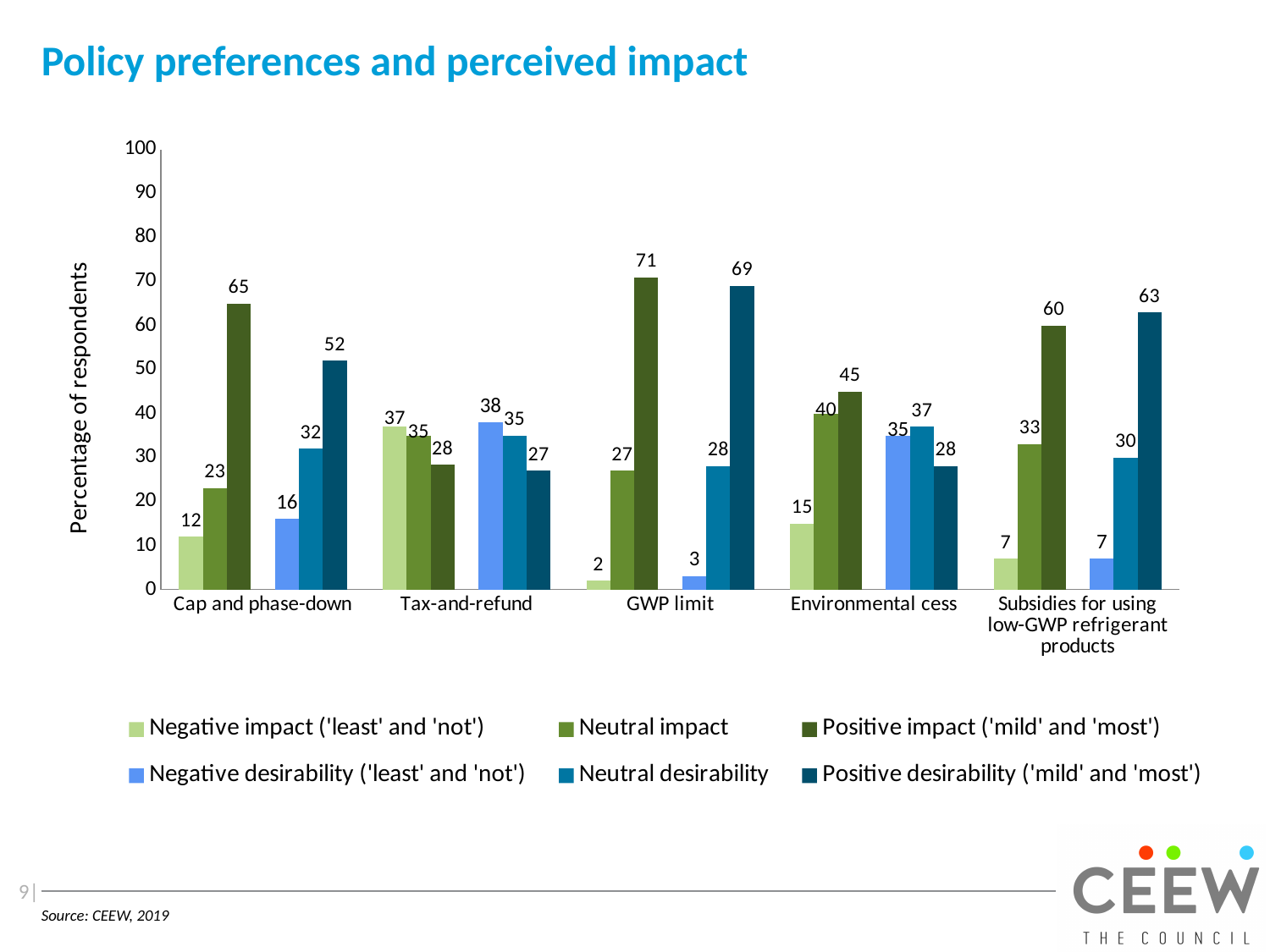
What is the label of the y axis? Percentage of respondents What kind of chart is shown on the slide? Bar chart Which is larger for Environmental cess: Positive impact ('mild' and 'most') or Positive desirability ('mild' and 'most')? Positive impact ('mild' and 'most') What is the value for Neutral desirability for Environmental cess? 37 Which policy has the lowest value for Negative impact ('least' and 'not')? GWP limit How many policy categories are shown on the x axis? 5 Which policy has the highest value for Positive desirability ('mild' and 'most')? GWP limit What is the value for Positive impact ('mild' and 'most') for GWP limit? 71 Is the value for Positive impact ('mild' and 'most') for Subsidies for using low-GWP refrigerant products greater or less than 50? greater What is the difference between Positive impact ('mild' and 'most') and Positive desirability ('mild' and 'most') for Cap and phase-down? 13 What is the value for Negative desirability ('least' and 'not') for Cap and phase-down? 16 How many series does the legend list? 6